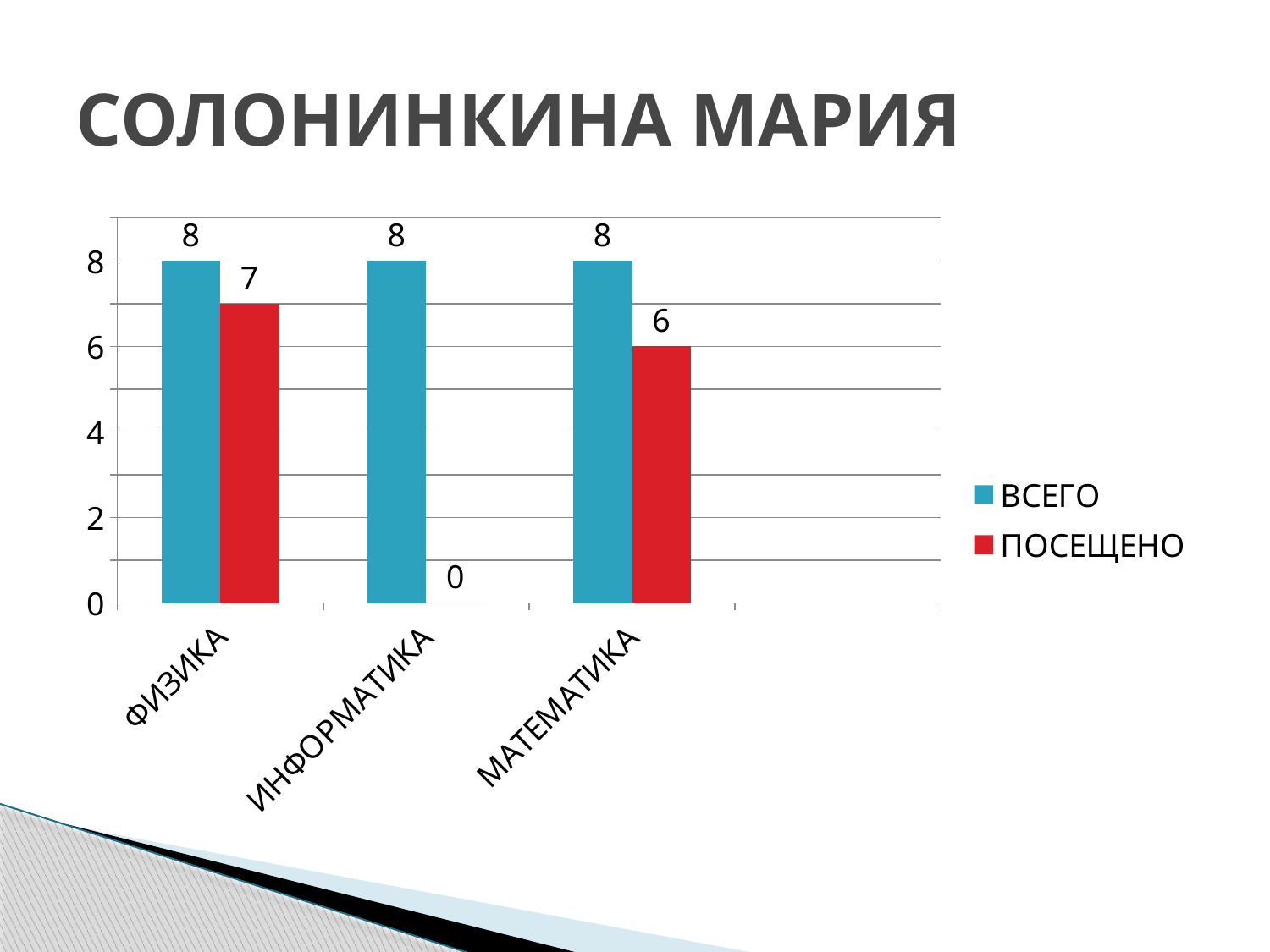
Which is larger for ФИЗИКА: ВСЕГО or ПОСЕЩЕНО? ВСЕГО How many series does the legend list? 2 What colour are the ПОСЕЩЕНО bars? Red Which category has the lowest ПОСЕЩЕНО value? ИНФОРМАТИКА What is the ПОСЕЩЕНО value for МАТЕМАТИКА? 6 How many categories are shown on the x axis? 3 What is the ВСЕГО value for МАТЕМАТИКА? 8 What kind of chart is shown on the slide? Bar chart What is the ПОСЕЩЕНО value for ФИЗИКА? 7 Which category has the highest ПОСЕЩЕНО value? ФИЗИКА What is the difference between ВСЕГО and ПОСЕЩЕНО for МАТЕМАТИКА? 2 What is the ПОСЕЩЕНО value for ИНФОРМАТИКА? 0